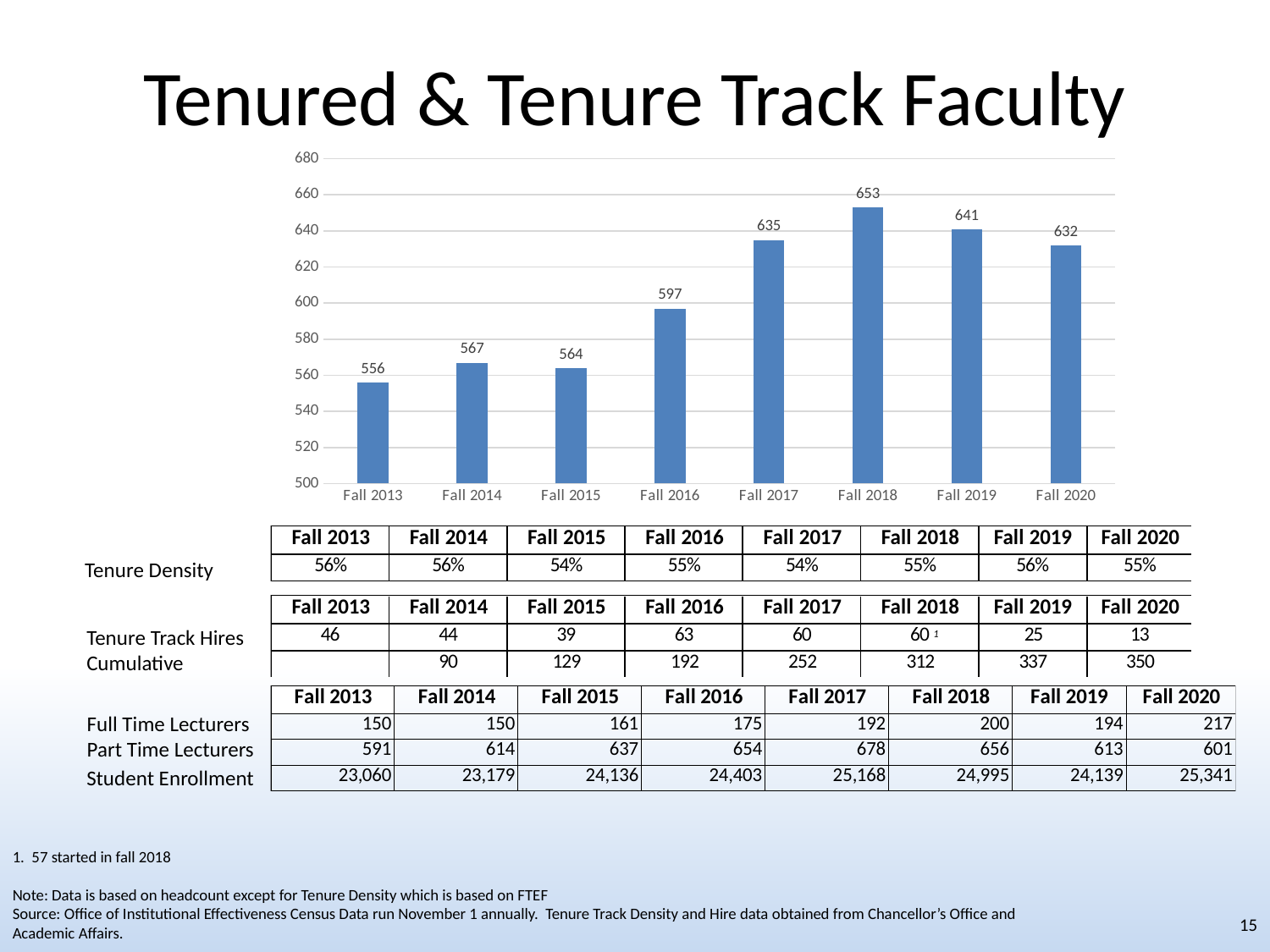
Do the values in the Tenured & Tenure Track Faculty chart generally rise or fall from Fall 2013 to Fall 2018? Rise Which is larger in the Tenured & Tenure Track Faculty chart, Fall 2014 or Fall 2015? Fall 2014 What is the difference between the Fall 2018 and Fall 2013 values in the Tenured & Tenure Track Faculty chart? 97 What is the value for Fall 2020 in the Tenured & Tenure Track Faculty chart? 632 What is the difference between the Fall 2017 and Fall 2016 values in the Tenured & Tenure Track Faculty chart? 38 What is the value for Fall 2016 in the Tenured & Tenure Track Faculty chart? 597 What is the title of the chart on the slide? Tenured & Tenure Track Faculty What kind of chart is used for Tenured & Tenure Track Faculty? Bar chart How many years are shown on the x axis of the Tenured & Tenure Track Faculty chart? 8 Which year has the highest value in the Tenured & Tenure Track Faculty chart? Fall 2018 Is the value for Fall 2019 in the Tenured & Tenure Track Faculty chart greater or less than 620? greater Which year has the lowest value in the Tenured & Tenure Track Faculty chart? Fall 2013